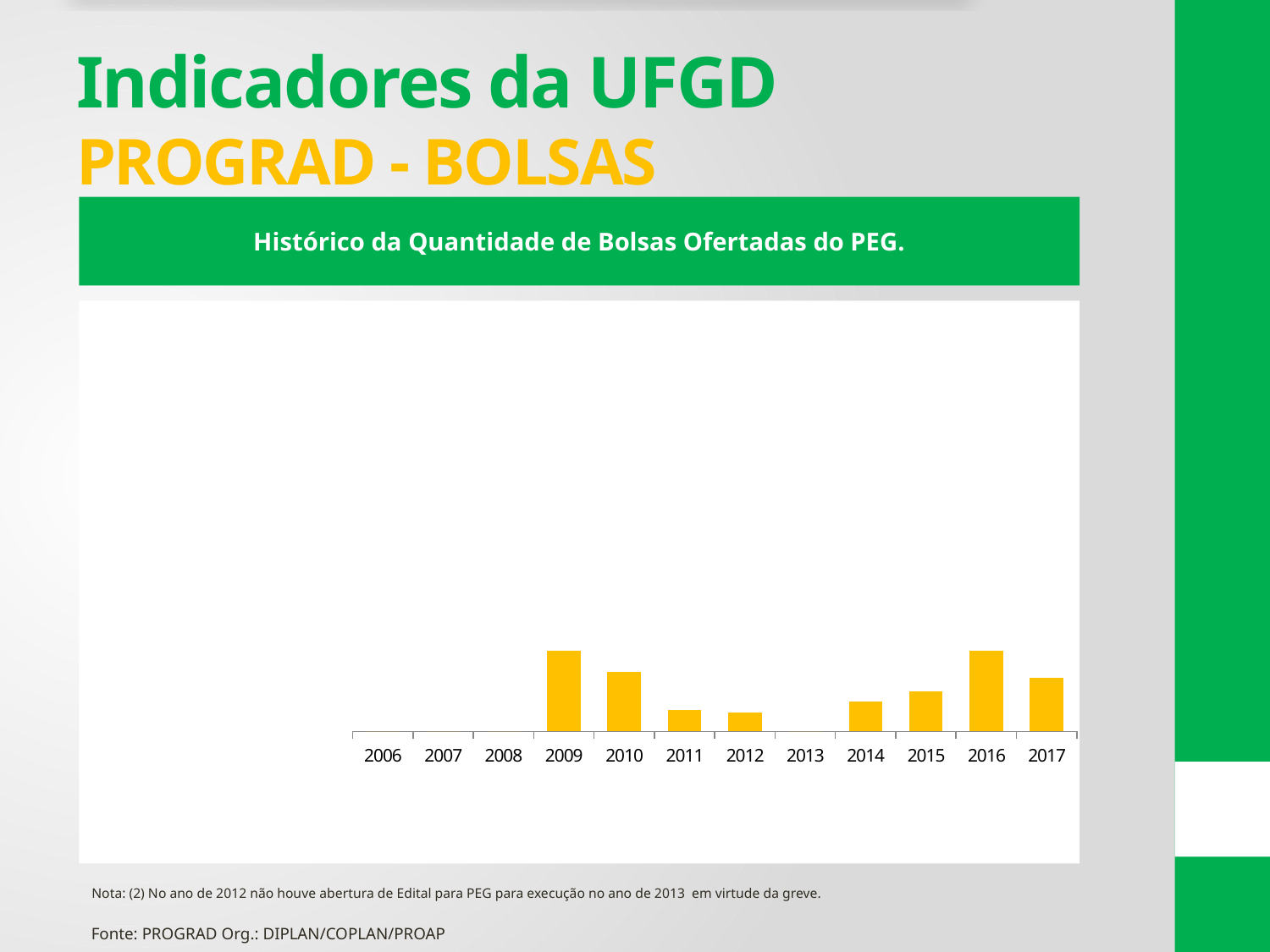
How many years are shown on the x axis of the chart? 12 Which is larger, the value for 2016 or the value for 2017? 2016 What is the last year shown on the x axis? 2017 Which is larger, the value for 2009 or the value for 2012? 2009 Among the years with a visible bar, which year has the lowest value? 2012 Do the values rise or fall from 2009 to 2012? fall What kind of chart is shown on the slide? bar chart Which is larger, the value for 2009 or the value for 2010? 2009 What is the first year shown on the x axis? 2006 Which years on the chart show no visible bar? 2006, 2007, 2008, 2013 Do the values rise or fall from 2014 to 2016? rise